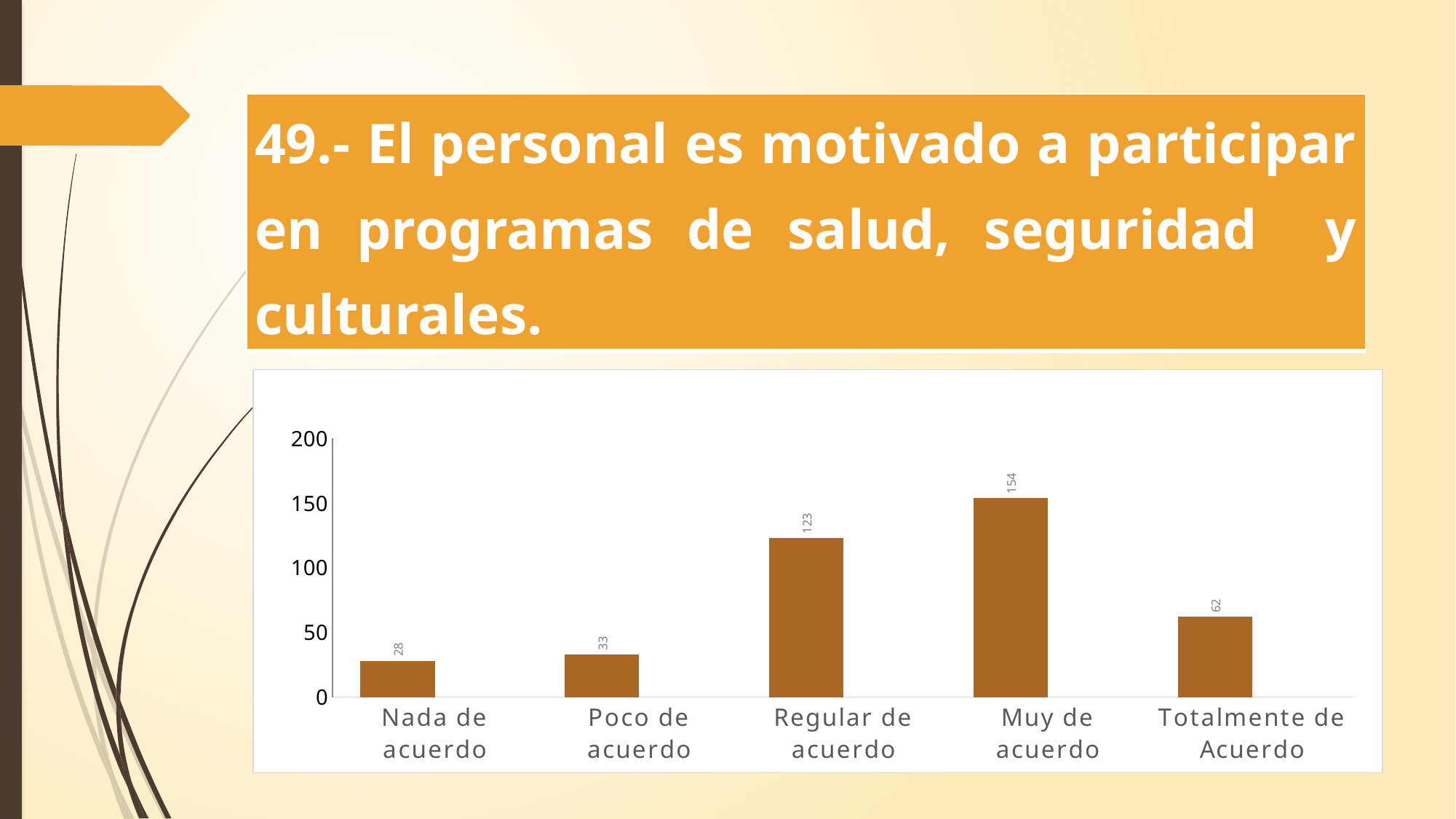
Is the value for "Regular de acuerdo" greater or less than 100? greater What is the total of all five values shown in the chart? 400 How many categories are shown on the x axis? 5 Which category has the highest value? Muy de acuerdo What is the value for "Muy de acuerdo"? 154 What is the value for "Totalmente de Acuerdo"? 62 Which category has the lowest value? Nada de acuerdo What is the difference between the values for "Totalmente de Acuerdo" and "Poco de acuerdo"? 29 What kind of chart is shown on the slide? bar chart What is the value for "Nada de acuerdo"? 28 Which is larger, the value for "Regular de acuerdo" or the value for "Totalmente de Acuerdo"? Regular de acuerdo What is the difference between the values for "Muy de acuerdo" and "Regular de acuerdo"? 31